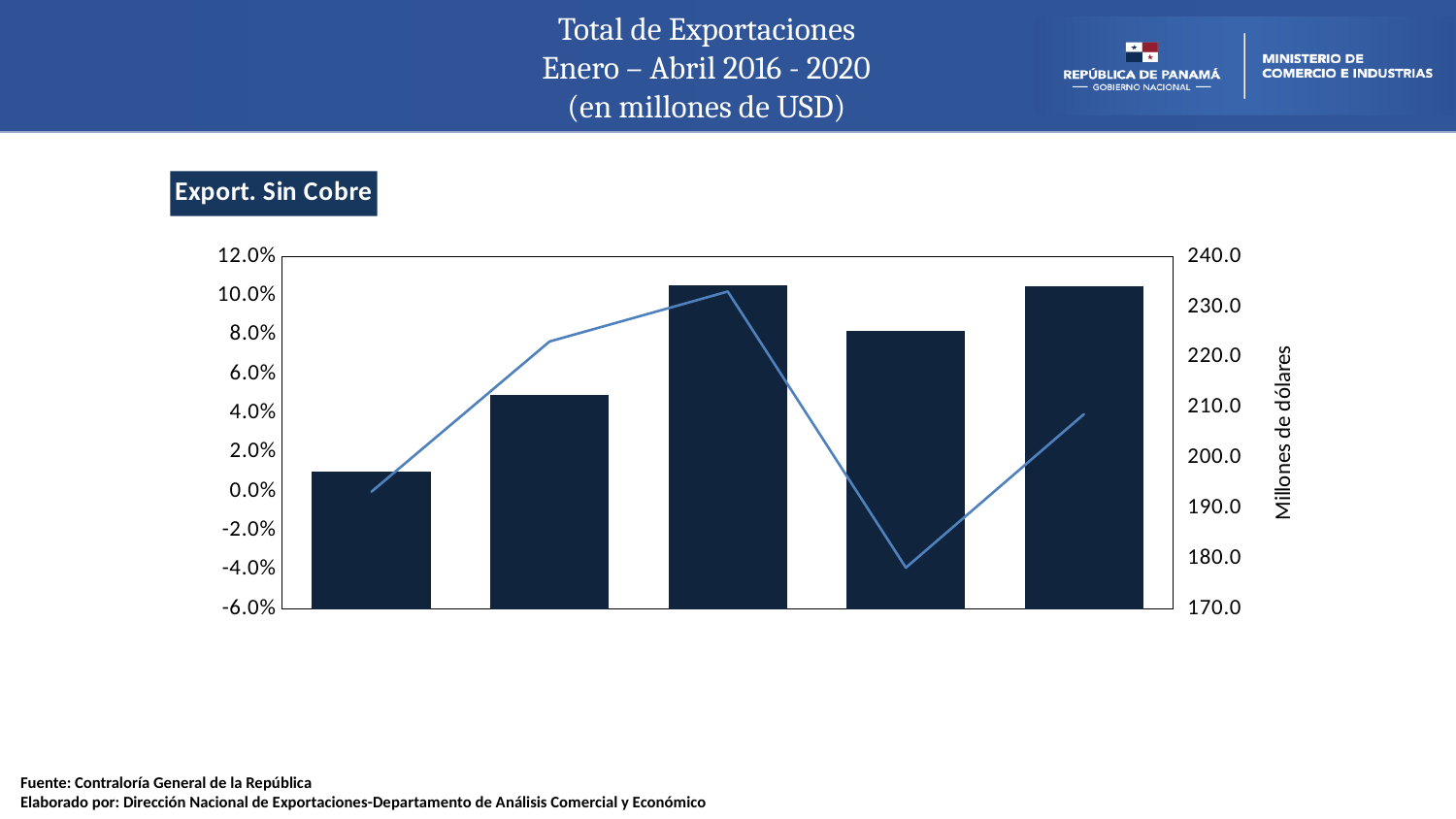
Does the line rise or fall from the first point to the third point? Rise What kind of chart is shown on the slide? A bar chart combined with a line How many bars are plotted in the chart? 5 Which bar is the shortest in the chart? The first bar Is the value of the fourth point on the line greater or less than -2.0%? less Which is larger, the second bar or the fourth bar? The fourth bar What is the label of the right-hand vertical axis? Millones de dólares Is the value of the second bar greater or less than 220.0 on the right axis? less Which point on the line is the lowest? The fourth point Is the value of the first bar greater or less than 190.0 on the right axis? greater What is the title of the chart? Export. Sin Cobre Which point on the line is the highest? The third point